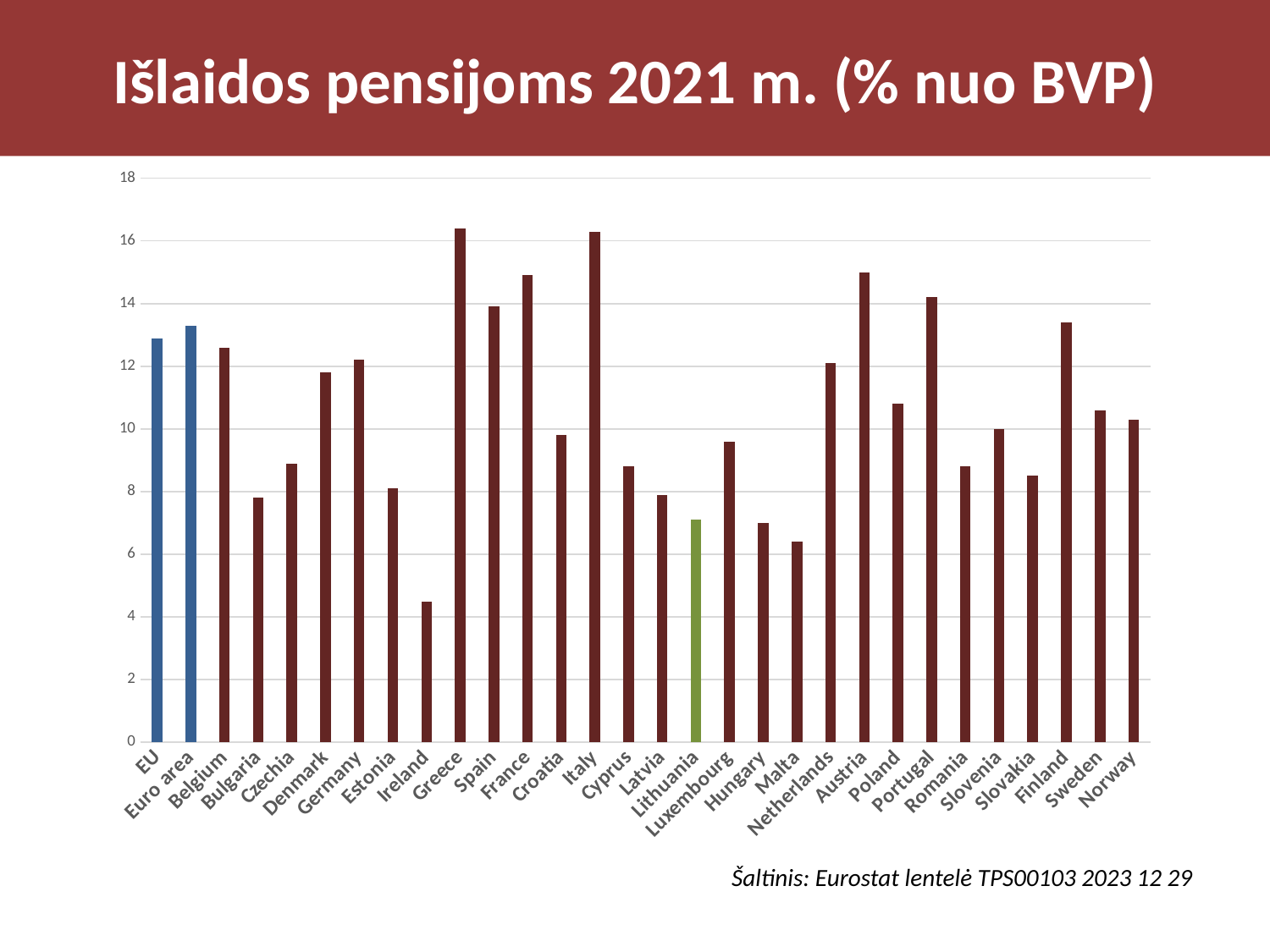
Is the value for Greece greater or less than 16? greater Is the value for Ireland greater or less than 6? less How many categories (bars) are shown on the chart? 30 Which category has the lowest value on the chart? Ireland Is the value for Malta greater or less than 8? less Which has a higher value, France or Spain? France Which has a higher value, Austria or Poland? Austria What is the title of the chart on the slide? Išlaidos pensijoms 2021 m. (% nuo BVP) What kind of chart is shown on the slide? bar chart